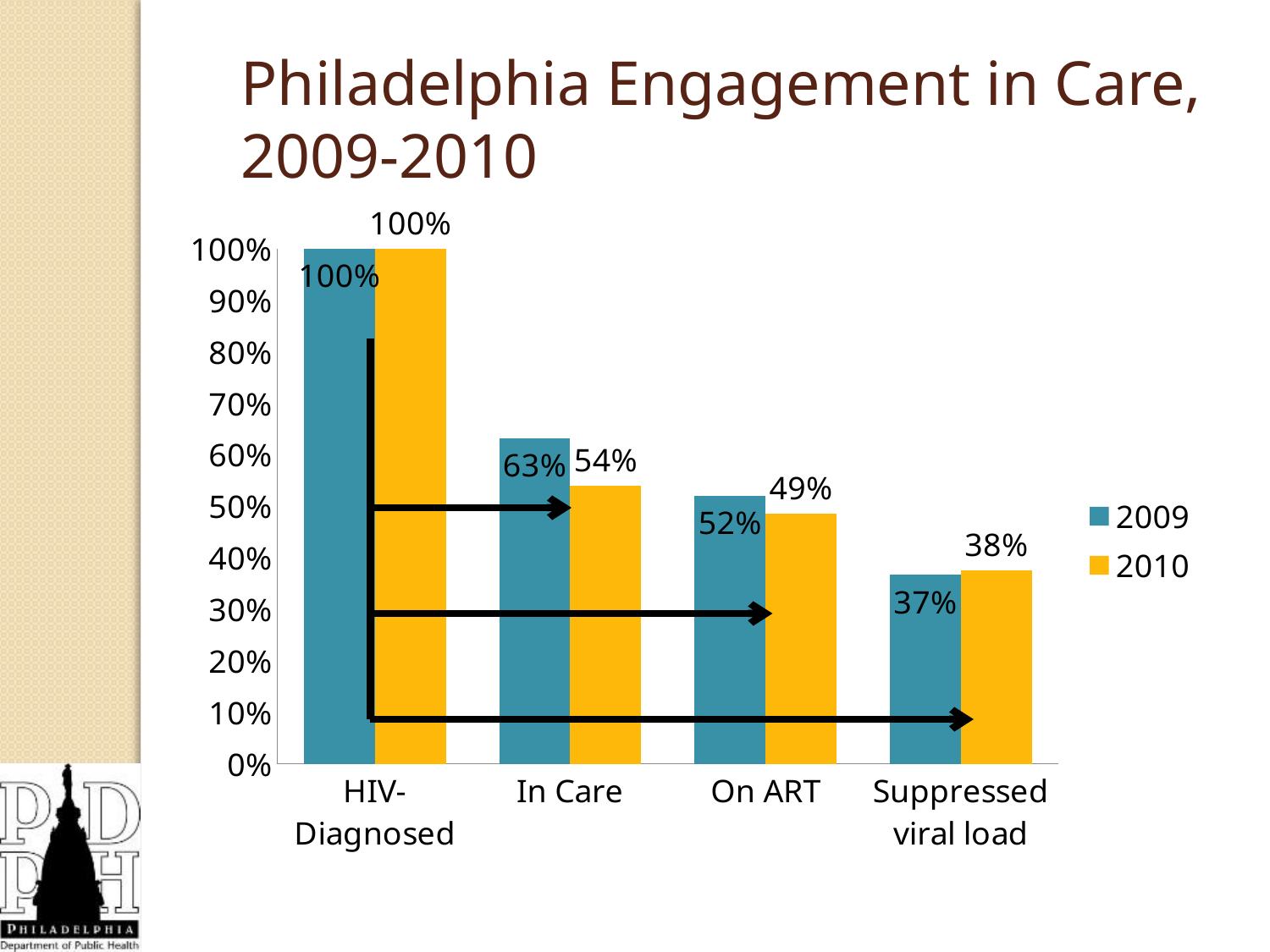
Which category has the lowest 2009 value? Suppressed viral load Do the 2010 values rise or fall from HIV-Diagnosed to Suppressed viral load? Fall How many series does the legend list? 2 What is the 2010 value for On ART? 49% What is the 2009 value for In Care? 63% How many categories are shown on the x axis? 4 What is the difference between the 2009 and 2010 values for In Care? 9% What is the 2009 value for On ART? 52% What kind of chart is shown on the slide? Bar chart Which is larger for On ART, the 2009 value or the 2010 value? 2009 What is the 2010 value for Suppressed viral load? 38% Which category has the highest 2010 value? HIV-Diagnosed